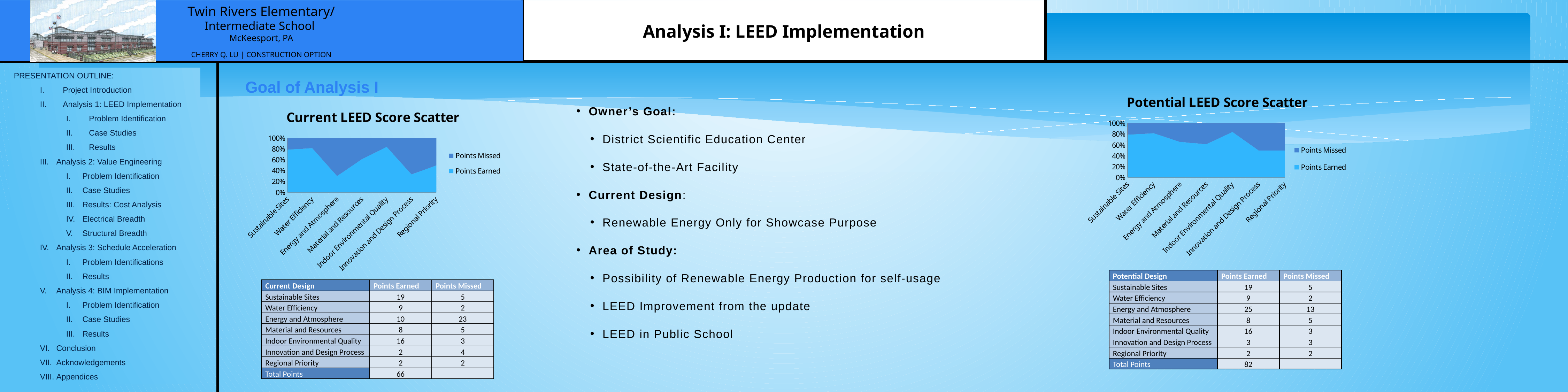
What are the two series named in the legend of the Current LEED Score Scatter chart? Points Missed and Points Earned In the Current LEED Score Scatter chart, which has the larger Points Earned share, Sustainable Sites or Energy and Atmosphere? Sustainable Sites How many categories are shown on the x axis of the Potential LEED Score Scatter chart? 7 In the Potential LEED Score Scatter chart, which has the larger Points Earned share, Indoor Environmental Quality or Regional Priority? Indoor Environmental Quality How many series does the legend of the Potential LEED Score Scatter chart list? 2 What kind of chart is the Current LEED Score Scatter chart? Stacked area chart In the Potential LEED Score Scatter chart, is the Points Earned share for Energy and Atmosphere greater or less than 60%? greater How many categories are shown on the x axis of the Current LEED Score Scatter chart? 7 What is the highest value shown on the y axis of the Potential LEED Score Scatter chart? 100% In the Current LEED Score Scatter chart, is the Points Earned share for Energy and Atmosphere greater or less than 40%? less In the Current LEED Score Scatter chart, is the Points Earned share for Sustainable Sites greater or less than 60%? greater